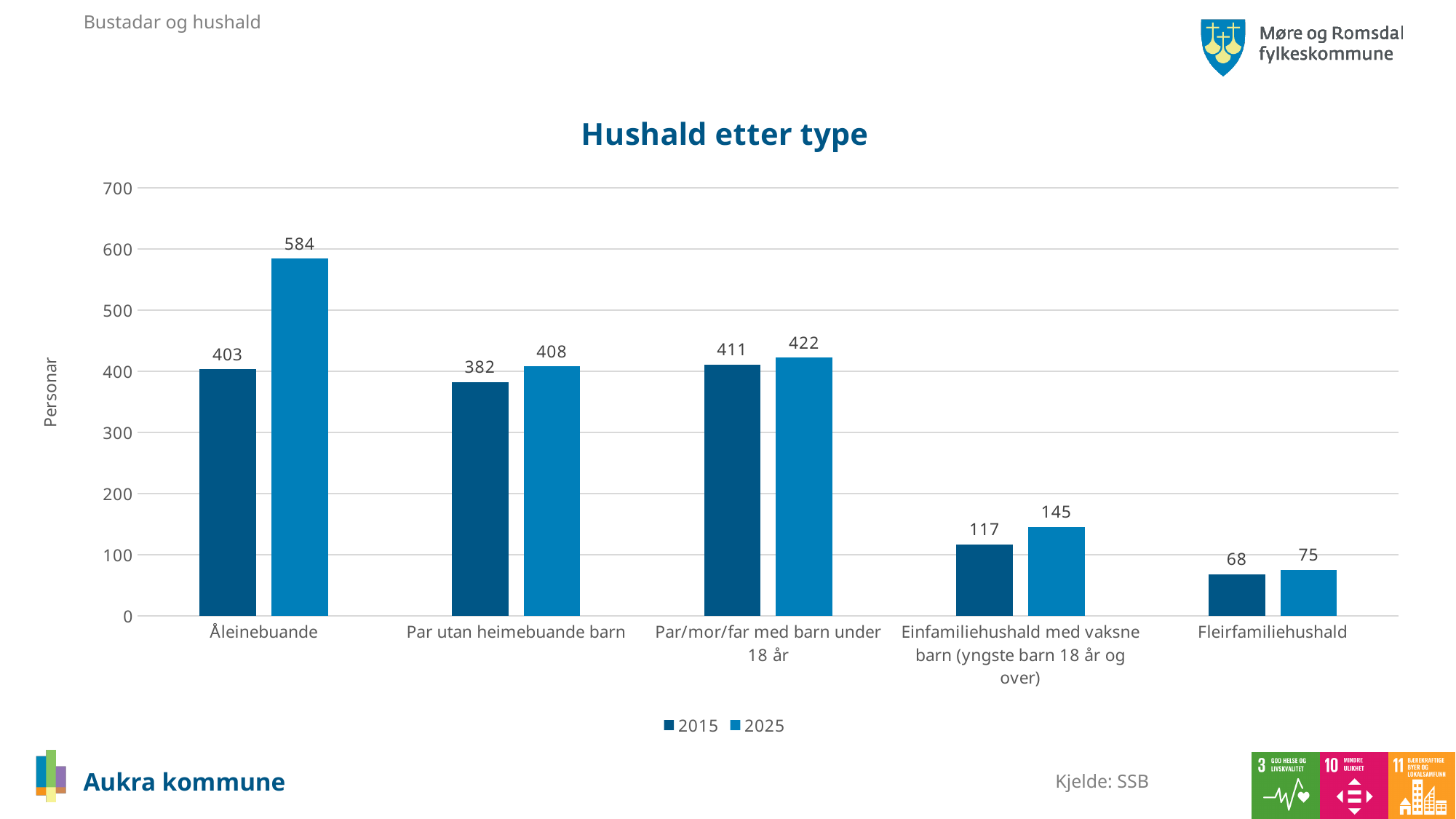
Which category has the highest value in 2025? Åleinebuande What is the title of the chart? Hushald etter type Which category has the lowest value in 2015? Fleirfamiliehushald How many series does the legend list? 2 What is the value for Åleinebuande in 2025? 584 What is the difference between the 2025 and 2015 values for Åleinebuande? 181 How many household categories are shown on the x axis? 5 What is the value for Fleirfamiliehushald in 2025? 75 What kind of chart is shown on the slide? Bar chart What is the label on the vertical axis? Personar Which is larger for Einfamiliehushald med vaksne barn (yngste barn 18 år og over): the 2015 value or the 2025 value? 2025 What is the value for Par utan heimebuande barn in 2015? 382